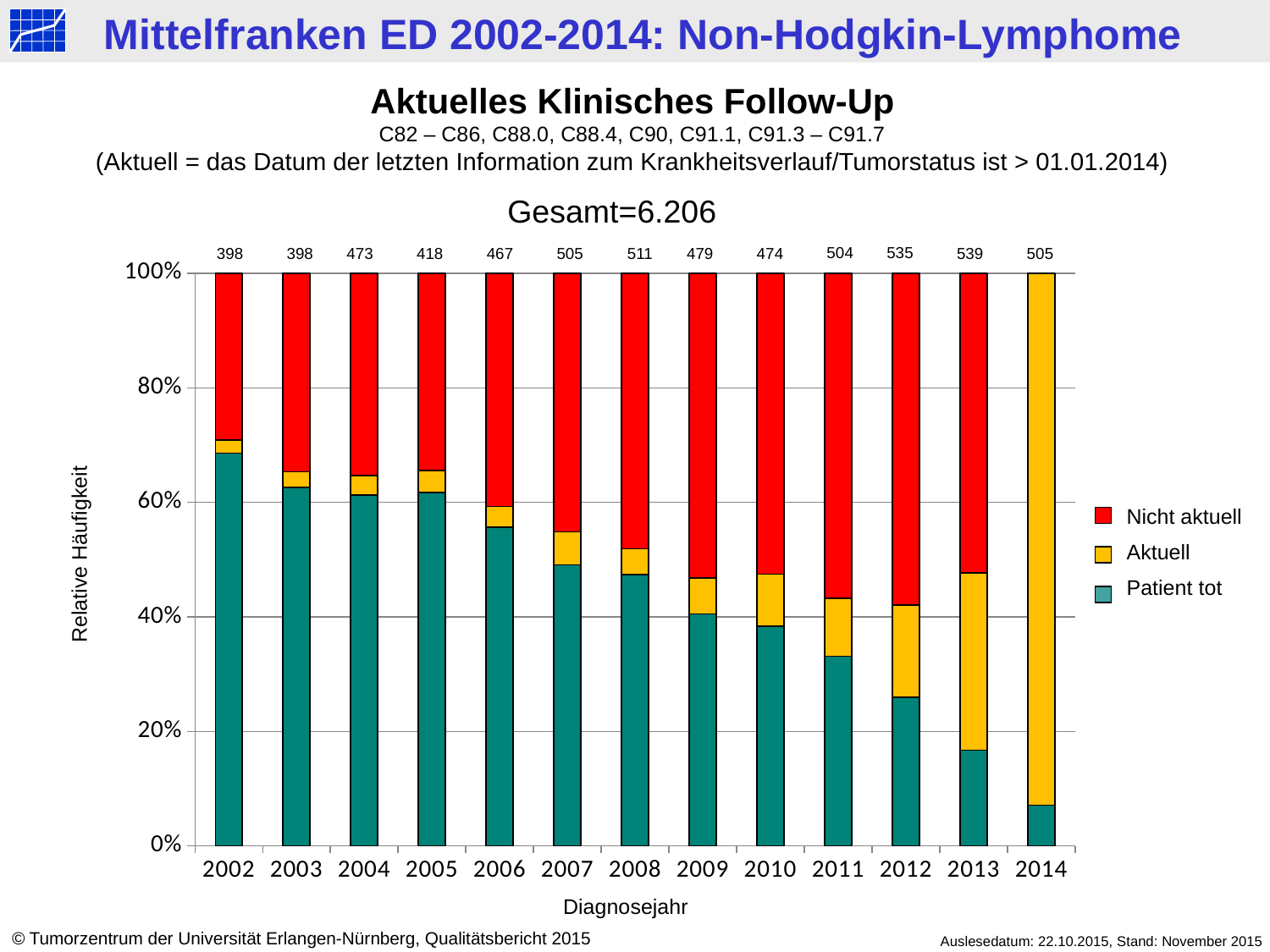
How many series does the legend list? 3 How many diagnosis years are shown on the x axis? 13 Is the 'Patient tot' share for 2002 greater or less than 60%? greater Is the 'Patient tot' share for 2014 greater or less than 20%? less What is the difference between the numbers printed above the bars for 2013 and 2012? 4 Which diagnosis year has the highest number printed above its bar? 2013 What is the number printed above the bar for 2011? 504 Which diagnosis years have the lowest number printed above their bars? 2002 and 2003 Which is larger, the 'Patient tot' share in 2002 or in 2013? 2002 What kind of chart is shown on the slide? Stacked bar chart What is the number printed above the bar for 2007? 505 Does the 'Patient tot' share rise or fall from 2002 to 2014? fall